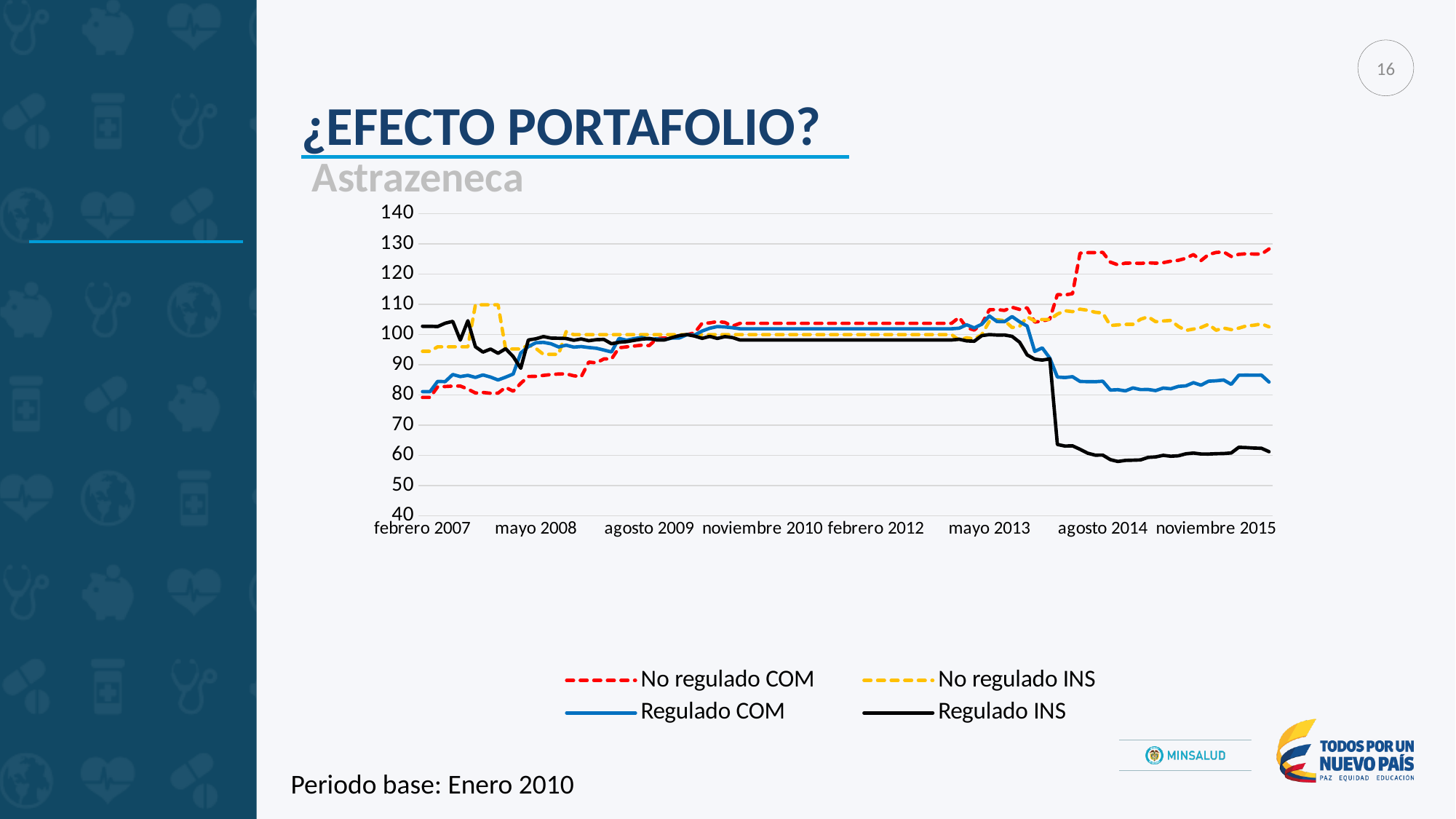
At noviembre 2015, which is higher: No regulado COM or Regulado INS? No regulado COM Does the Regulado INS series rise or fall between mayo 2013 and agosto 2014? fall Is the value for No regulado COM at noviembre 2015 greater or less than 120? greater Is the value for Regulado INS at noviembre 2015 greater or less than 70? less Which series has the lowest value at the end of the chart (noviembre 2015)? Regulado INS What kind of chart is shown on the slide? line chart How many series does the legend list? 4 Which series are listed in the legend? No regulado COM, No regulado INS, Regulado COM, Regulado INS Which series has the highest value at the end of the chart (noviembre 2015)? No regulado COM Which company is named as the subtitle of the chart? Astrazeneca Is the value for Regulado COM at febrero 2007 greater or less than 90? less